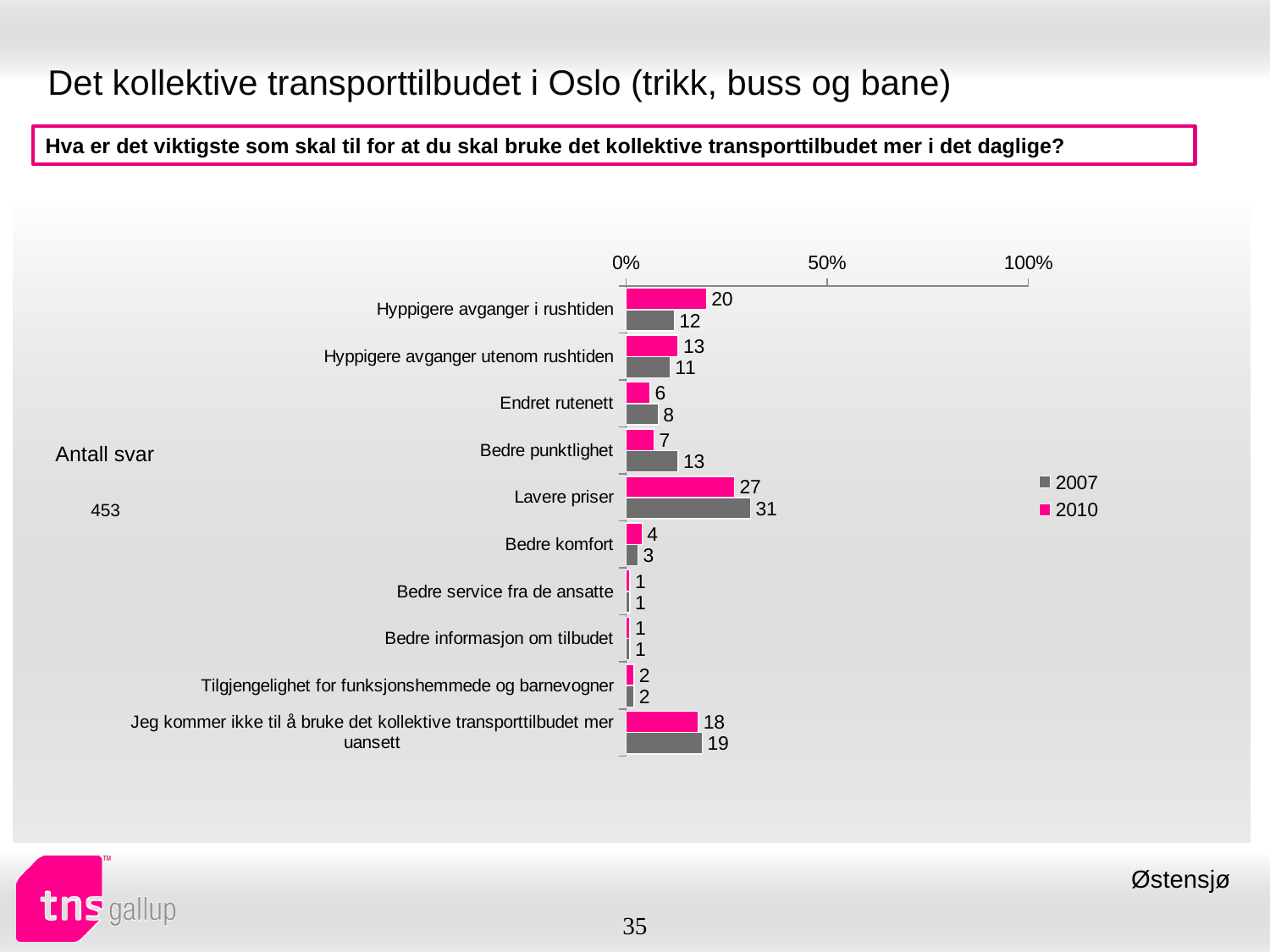
Which is larger for "Endret rutenett": the 2007 value or the 2010 value? 2007 What is the 2010 value for "Hyppigere avganger i rushtiden"? 20 Which category has the highest 2007 value? Lavere priser What kind of chart is shown on the slide? Bar chart How many series does the legend list? 2 What is the 2007 value for "Jeg kommer ikke til å bruke det kollektive transporttilbudet mer uansett"? 19 Which category has the highest 2010 value? Lavere priser What is the difference between the 2007 and 2010 values for "Bedre punktlighet"? 6 How many categories are shown on the chart? 10 What is the difference between the 2010 and 2007 values for "Hyppigere avganger i rushtiden"? 8 What is the 2007 value for "Bedre punktlighet"? 13 What is the 2010 value for "Lavere priser"? 27